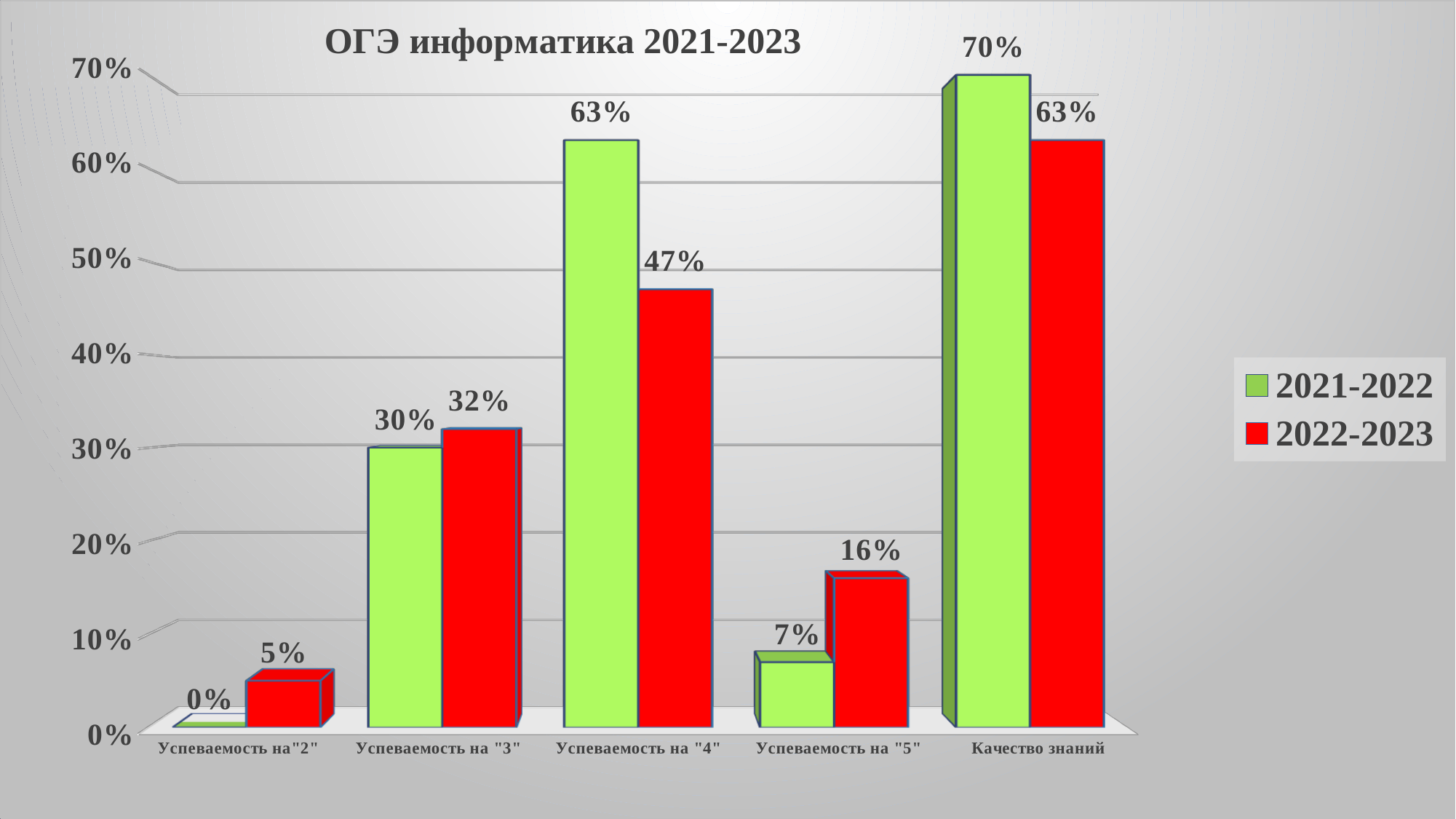
What is the value for 2022-2023 in the category Успеваемость на "5"? 16% What is the difference between the 2021-2022 and 2022-2023 values in the category Успеваемость на "4"? 16% In the category Качество знаний, which series has the larger value, 2021-2022 or 2022-2023? 2021-2022 How many categories are shown on the x axis? 5 What is the value for 2022-2023 in the category Успеваемость на"2"? 5% What is the title of the chart? ОГЭ информатика 2021-2023 Is the value for 2022-2023 in the category Успеваемость на "3" greater or less than 30%? greater What kind of chart is shown on the slide? bar chart Which category has the lowest value for the 2022-2023 series? Успеваемость на"2" How many series does the legend list? 2 What is the value for 2021-2022 in the category Успеваемость на "4"? 63% Which category has the highest value for the 2021-2022 series? Качество знаний